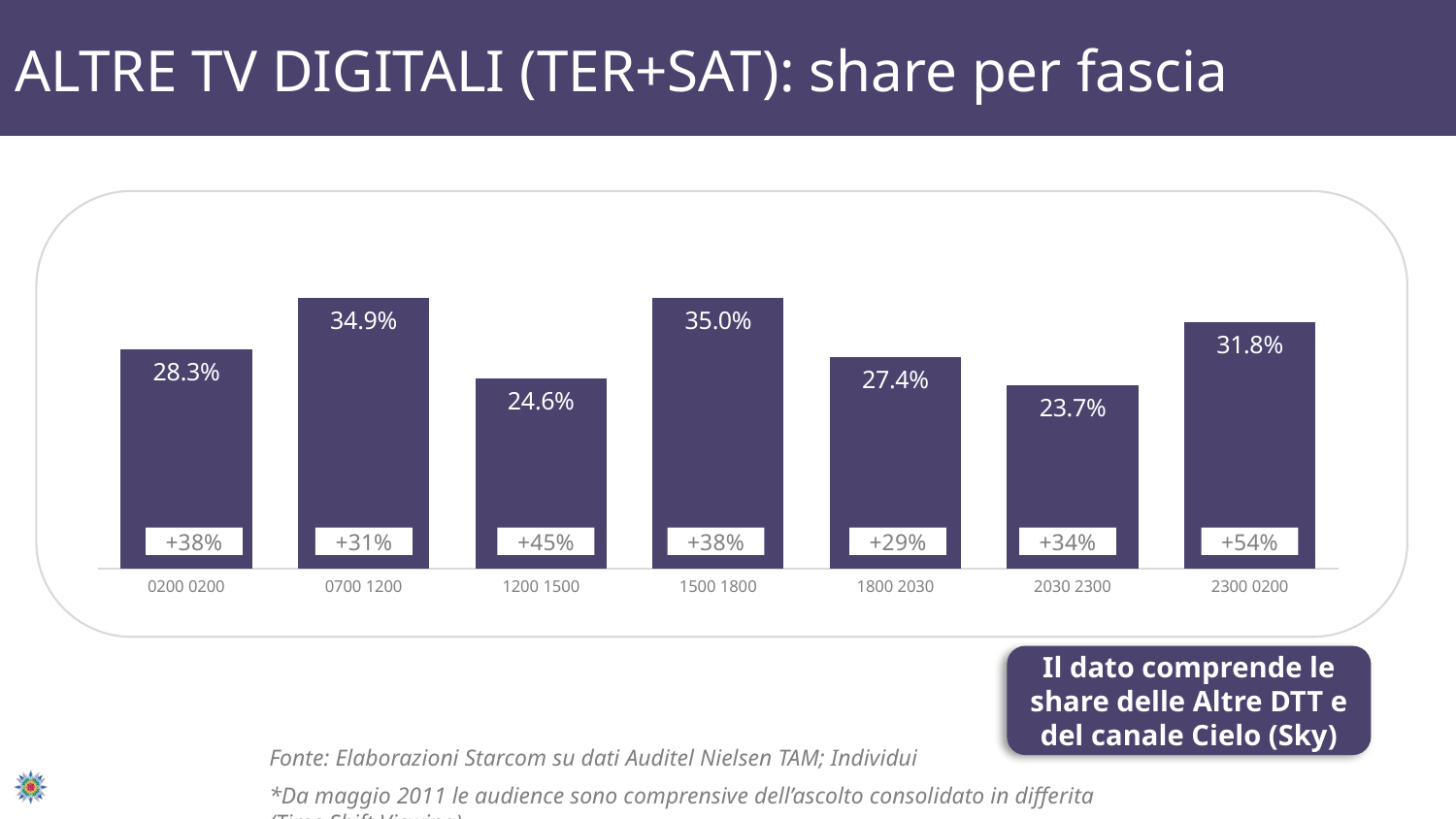
Which has a larger share, the 0200 0200 band or the 1200 1500 band? 0200 0200 How many time bands are shown in the chart? 7 What growth percentage is shown at the base of the 1200 1500 bar? +45% What is the title of the slide? ALTRE TV DIGITALI (TER+SAT): share per fascia What is the difference in share between the 1500 1800 and 1800 2030 time bands? 7.6% What is the share for the 0700 1200 time band? 34.9% What kind of chart is shown on the slide? Bar chart What is the share for the 1800 2030 time band? 27.4% Which time band has the lowest share? 2030 2300 Which time band shows the largest growth percentage at the base of its bar? 2300 0200 Which time band has the highest share? 1500 1800 What is the share for the 2300 0200 time band? 31.8%